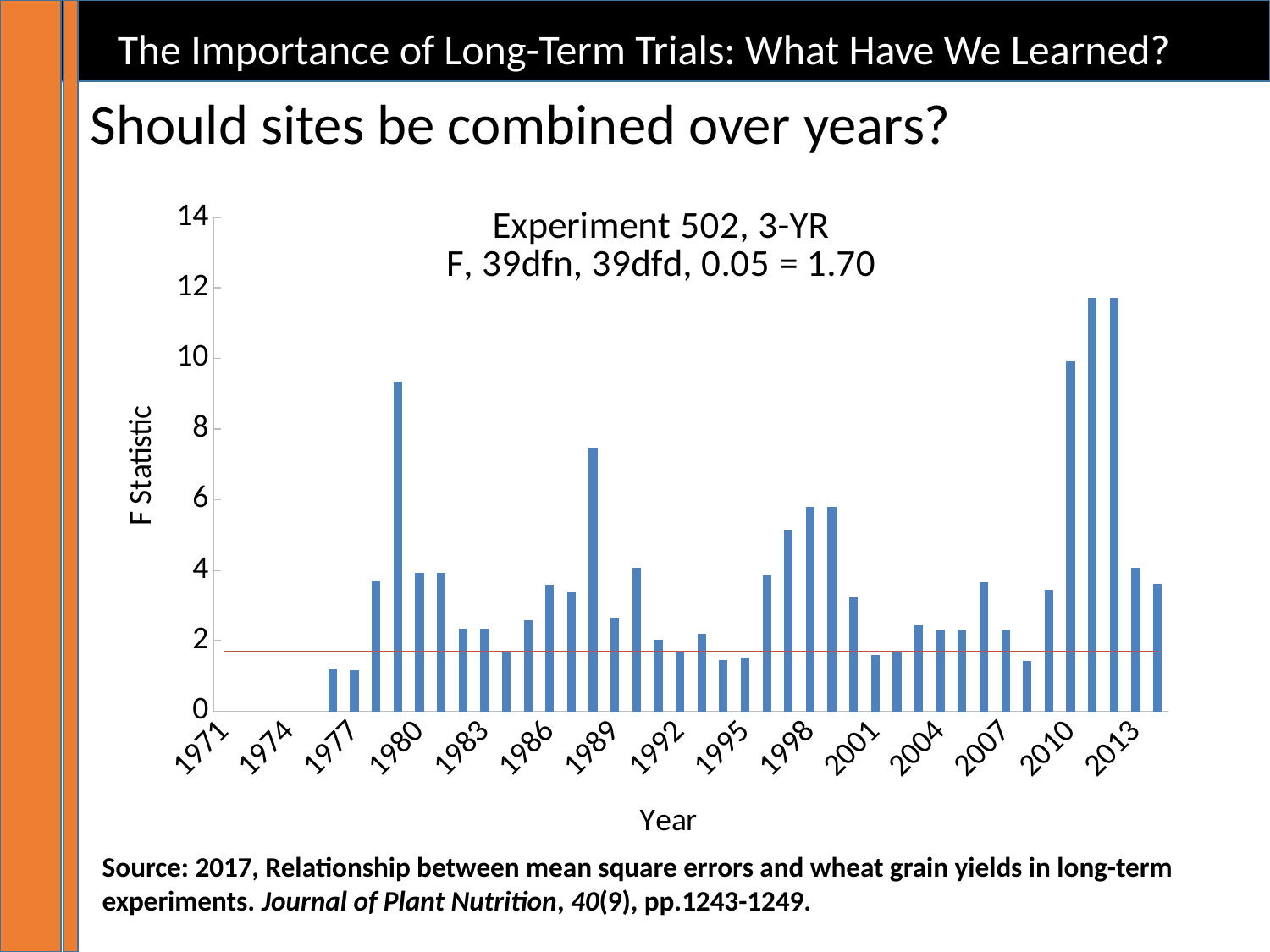
Is the value for 1998 greater or less than 4? greater Which year has the larger F statistic, 2010 or 2011? 2011 Is the value for 1977 greater or less than 2? less Is the value for 1995 greater or less than 2? less Which year has the larger F statistic, 1998 or 1988? 1988 What kind of chart is shown on the slide? bar chart What is the label of the vertical axis? F Statistic Which year has the larger F statistic, 1979 or 1988? 1979 What is the title of the chart? Experiment 502, 3-YR F, 39dfn, 39dfd, 0.05 = 1.70